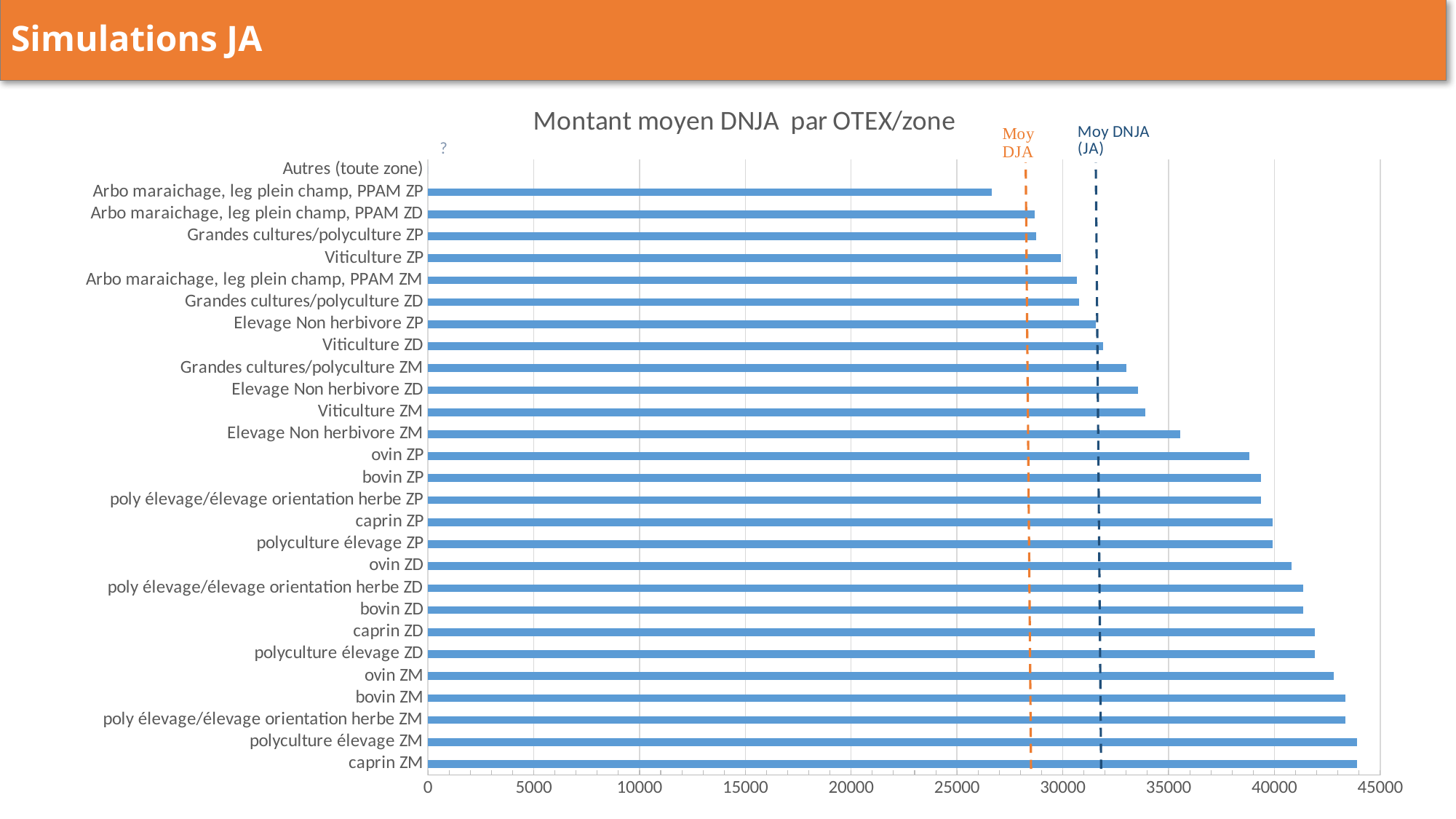
Which has the larger value, ovin ZM or ovin ZP? ovin ZM Is the value for Arbo maraichage, leg plein champ, PPAM ZP greater or less than 30000? less What kind of chart is shown on the slide? bar chart What are the labels of the two dashed vertical reference lines on the chart? Moy DJA and Moy DNJA (JA) How many categories are listed on the vertical axis of the chart? 28 Is the value for Viticulture ZD greater or less than 35000? less What is the title of the chart? Montant moyen DNJA par OTEX/zone Is the value for caprin ZM greater or less than 40000? greater Among the categories with a visible bar, which has the lowest value? Arbo maraichage, leg plein champ, PPAM ZP Which has the larger value, Viticulture ZM or Viticulture ZP? Viticulture ZM